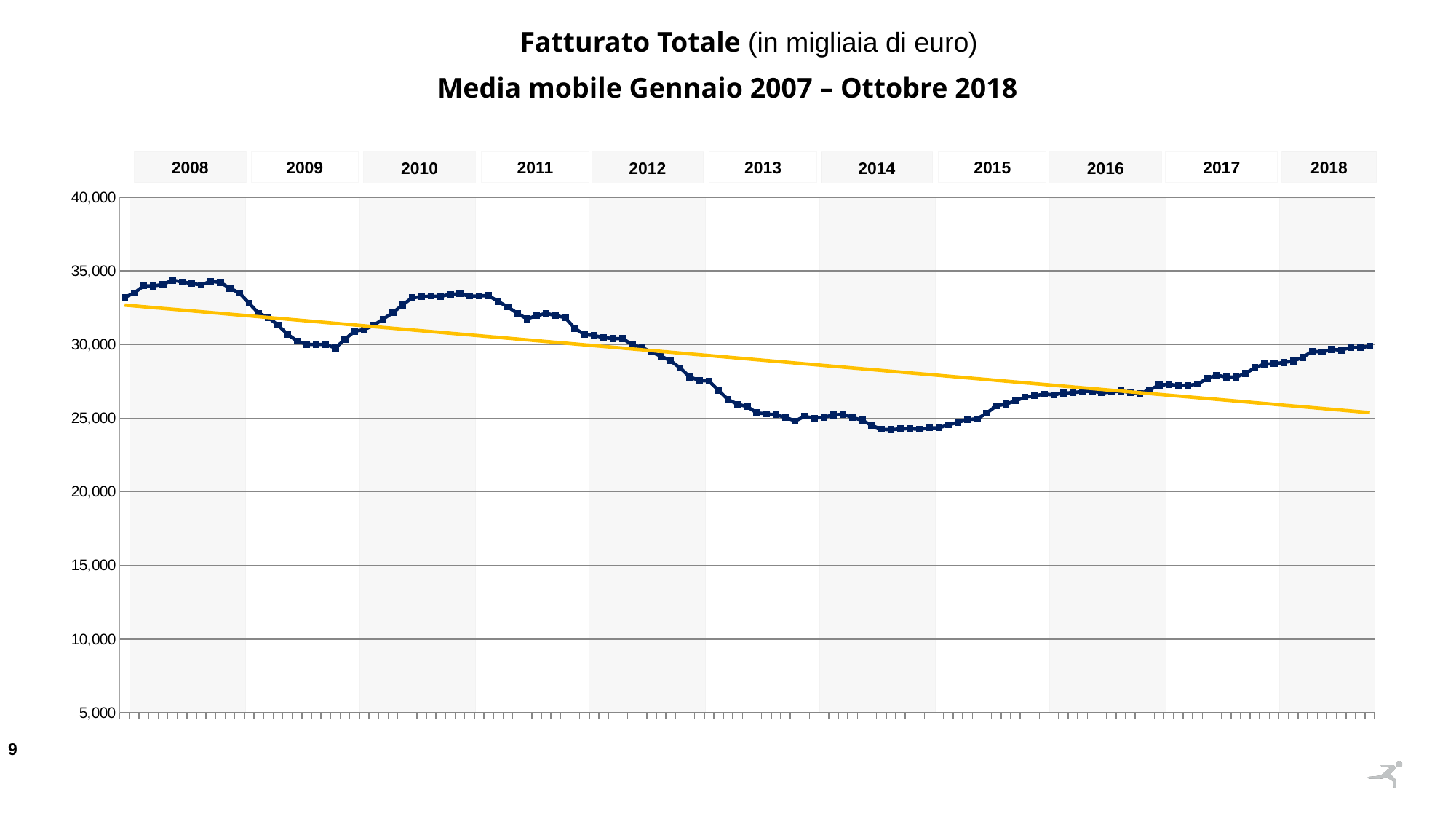
Is the yellow trend line at the end of the chart greater or less than 30,000? less What is the title of the chart? Fatturato Totale (in migliaia di euro) Media mobile Gennaio 2007 – Ottobre 2018 What is the highest value shown on the vertical axis? 40,000 How many year labels are shown along the top of the chart? 11 In which year does the blue moving-average line reach its lowest values? 2014 Is the value of the blue moving-average line in the middle of 2014 greater or less than 30,000? less Which is larger: the blue line's value in early 2008 or its value in mid 2014? early 2008 Is the yellow trend line at the start of the chart greater or less than 30,000? greater What kind of chart is shown on the slide? line chart Does the yellow trend line rise or fall from left to right across the chart? fall